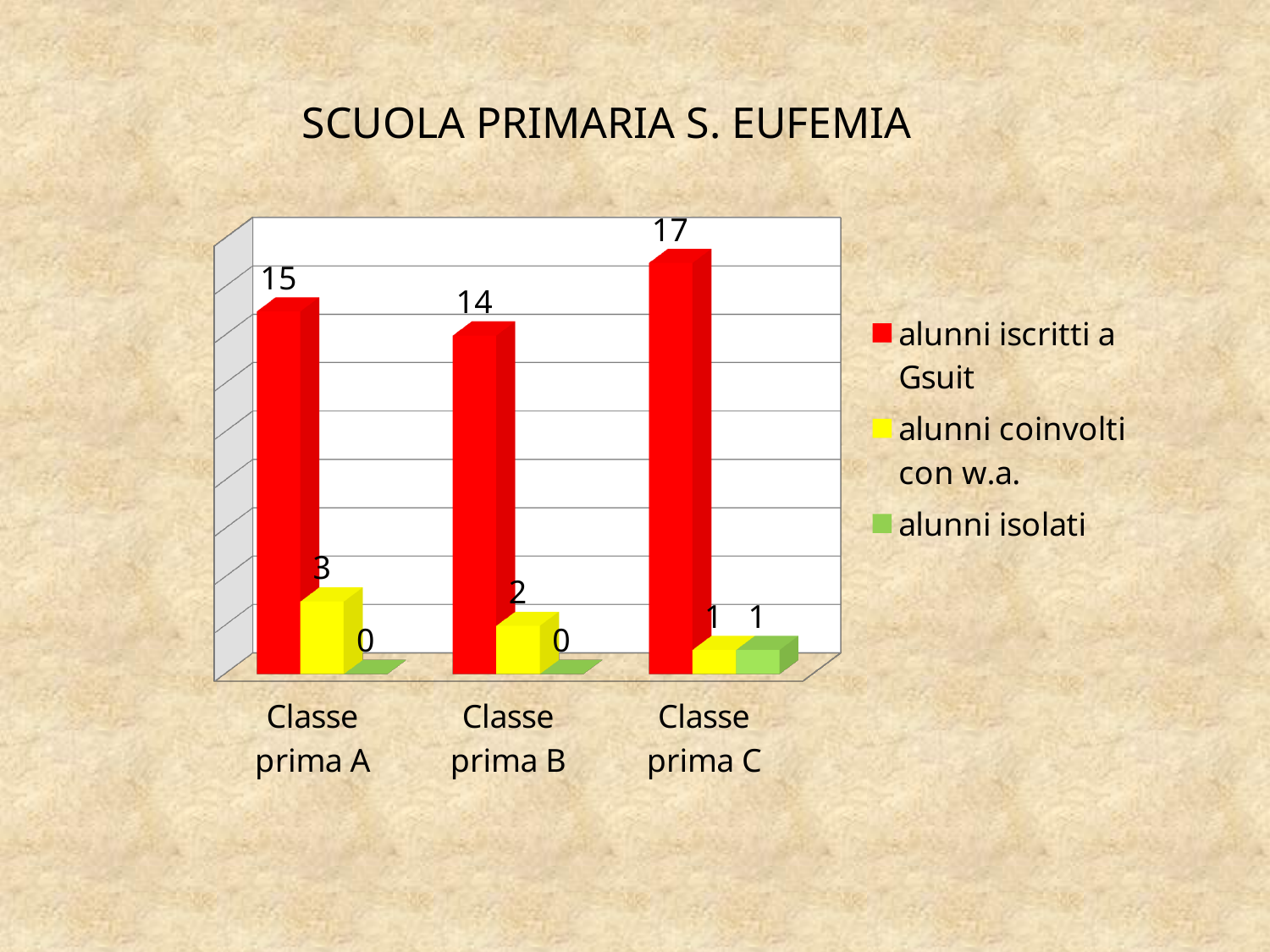
What kind of chart is shown on the slide? Bar chart How many classes are shown on the x axis? 3 How many alunni iscritti a Gsuit are there in Classe prima A? 15 What is the value for alunni coinvolti con w.a. in Classe prima B? 2 Which colour represents alunni isolati in the legend? Green Which is larger: alunni coinvolti con w.a. in Classe prima A or in Classe prima C? Classe prima A What is the value for alunni isolati in Classe prima C? 1 Which class has the highest number of alunni iscritti a Gsuit? Classe prima C Which class has the lowest number of alunni iscritti a Gsuit? Classe prima B What is the title of the slide? SCUOLA PRIMARIA S. EUFEMIA How many series does the legend list? 3 What is the difference between alunni iscritti a Gsuit in Classe prima C and Classe prima B? 3